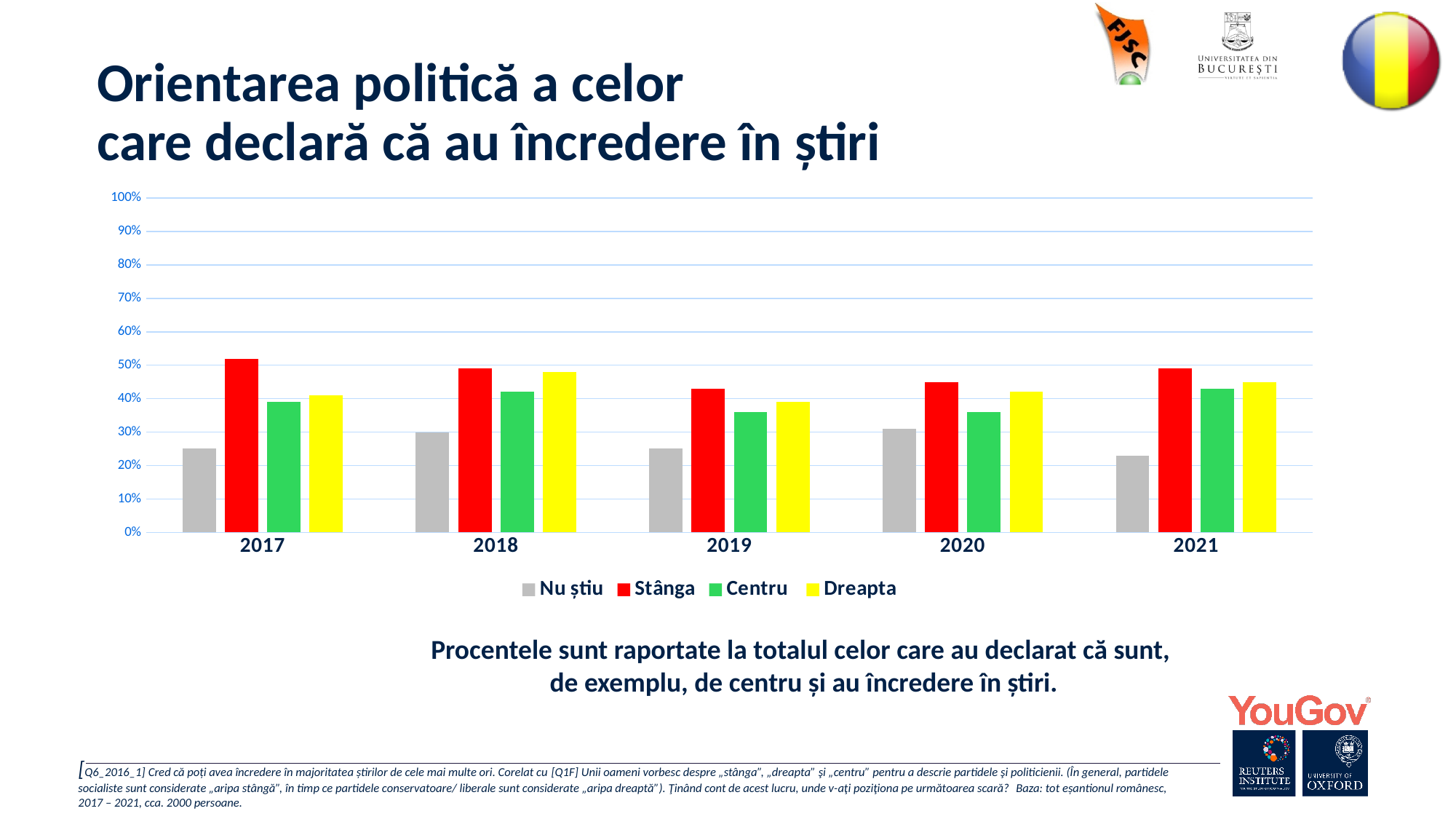
Does the value for Stânga rise or fall from 2017 to 2019? fall What colour represents Stânga in the legend? red Is the value for Stânga in 2019 greater or less than 40%? greater How many series does the legend list? 4 In 2018, which is larger: Dreapta or Centru? Dreapta Is the value for Centru in 2020 greater or less than 40%? less What kind of chart is shown on the slide? bar chart Which series has the lowest value in 2021? Nu știu In 2018, which is larger: Stânga or Centru? Stânga Is the value for Nu știu in 2017 greater or less than 30%? less How many years are shown on the x axis? 5 Which series has the highest value in 2017? Stânga